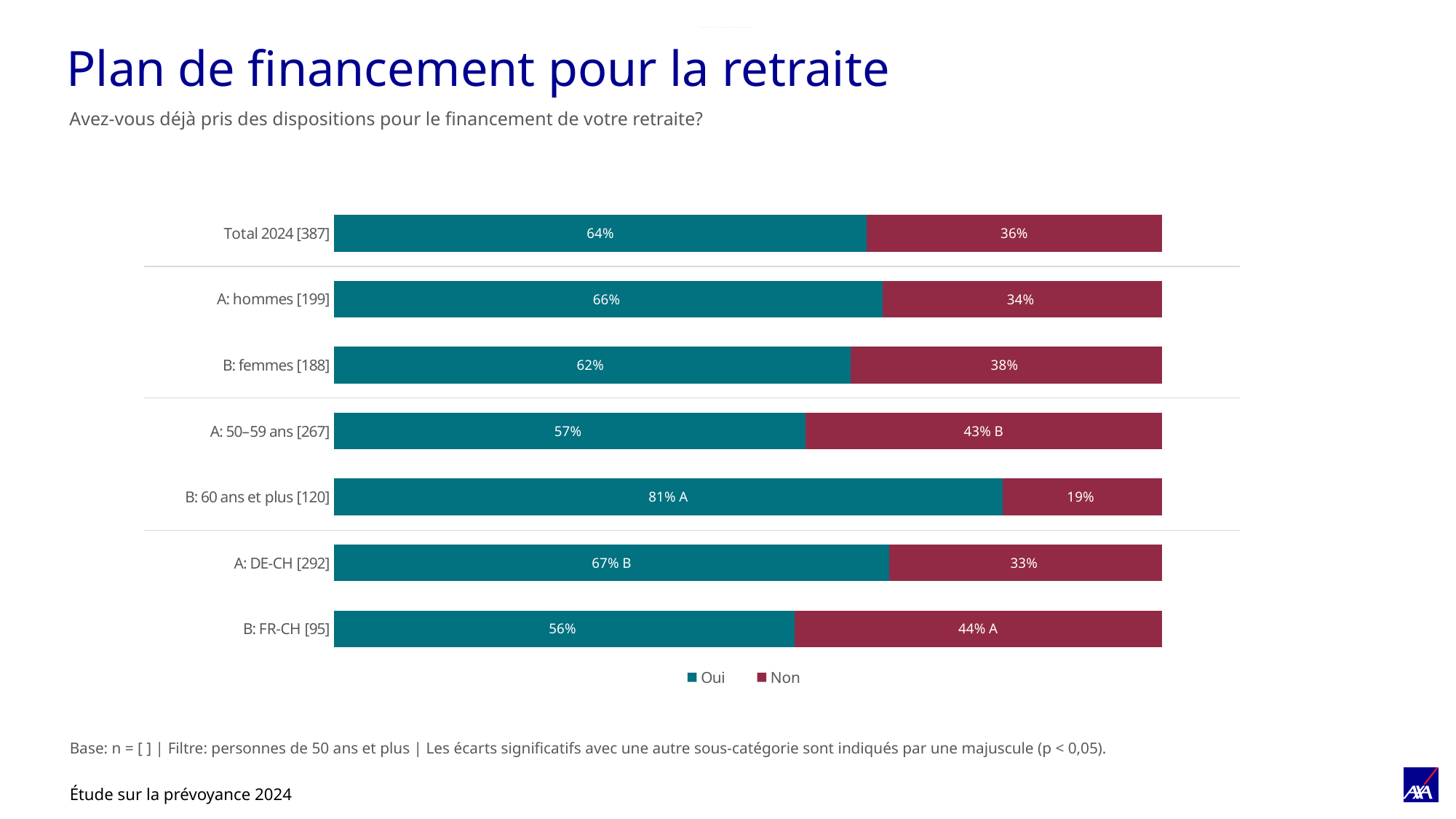
What kind of chart is shown on the slide? Stacked bar chart What is the 'Non' value for B: femmes [188]? 38% Which has a larger 'Oui' value, A: DE-CH [292] or B: FR-CH [95]? A: DE-CH [292] Which category has the highest 'Oui' value? B: 60 ans et plus [120] What is the difference between the 'Oui' values for A: hommes [199] and B: femmes [188]? 4% What is the 'Oui' value for B: 60 ans et plus [120]? 81% Which category has the lowest 'Non' value? B: 60 ans et plus [120] What is the 'Non' value for B: FR-CH [95]? 44% How many series does the legend list? 2 What is the total of the stacked bar for A: 50–59 ans [267]? 100% What is the 'Oui' value for Total 2024 [387]? 64% How many categories are shown in the chart? 7